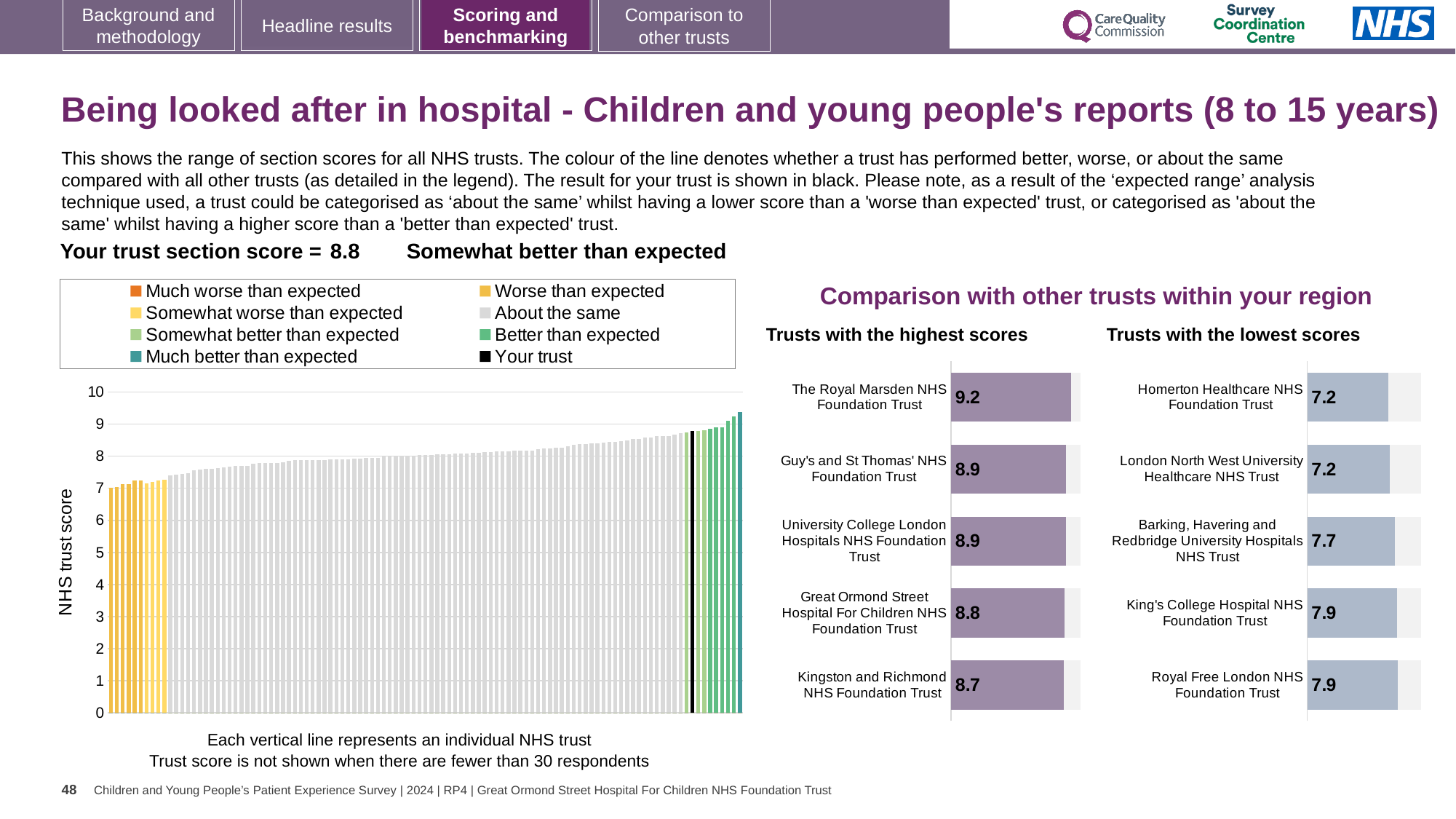
In the 'Trusts with the lowest scores' chart, what is the difference between the scores of King's College Hospital NHS Foundation Trust and London North West University Healthcare NHS Trust? 0.7 In the 'Trusts with the highest scores' chart, what is the difference between the scores of The Royal Marsden NHS Foundation Trust and Kingston and Richmond NHS Foundation Trust? 0.5 In the 'Trusts with the highest scores' chart, which trust has the highest score? The Royal Marsden NHS Foundation Trust How many entries does the legend above the large chart on the left list? 8 In the 'Trusts with the lowest scores' chart, what is the score for Homerton Healthcare NHS Foundation Trust? 7.2 What kind of chart is the large chart on the left showing NHS trust scores? Bar chart How many trusts are shown in the 'Trusts with the highest scores' chart? 5 In the 'Trusts with the highest scores' chart, what is the score for Great Ormond Street Hospital For Children NHS Foundation Trust? 8.8 In the 'Trusts with the lowest scores' chart, which has the larger score: Barking, Havering and Redbridge University Hospitals NHS Trust or Homerton Healthcare NHS Foundation Trust? Barking, Havering and Redbridge University Hospitals NHS Trust In the 'Trusts with the highest scores' chart, which trust has the lowest score? Kingston and Richmond NHS Foundation Trust In the large chart on the left, do the trust scores rise or fall from left to right? Rise In the 'Trusts with the highest scores' chart, what is the score for The Royal Marsden NHS Foundation Trust? 9.2